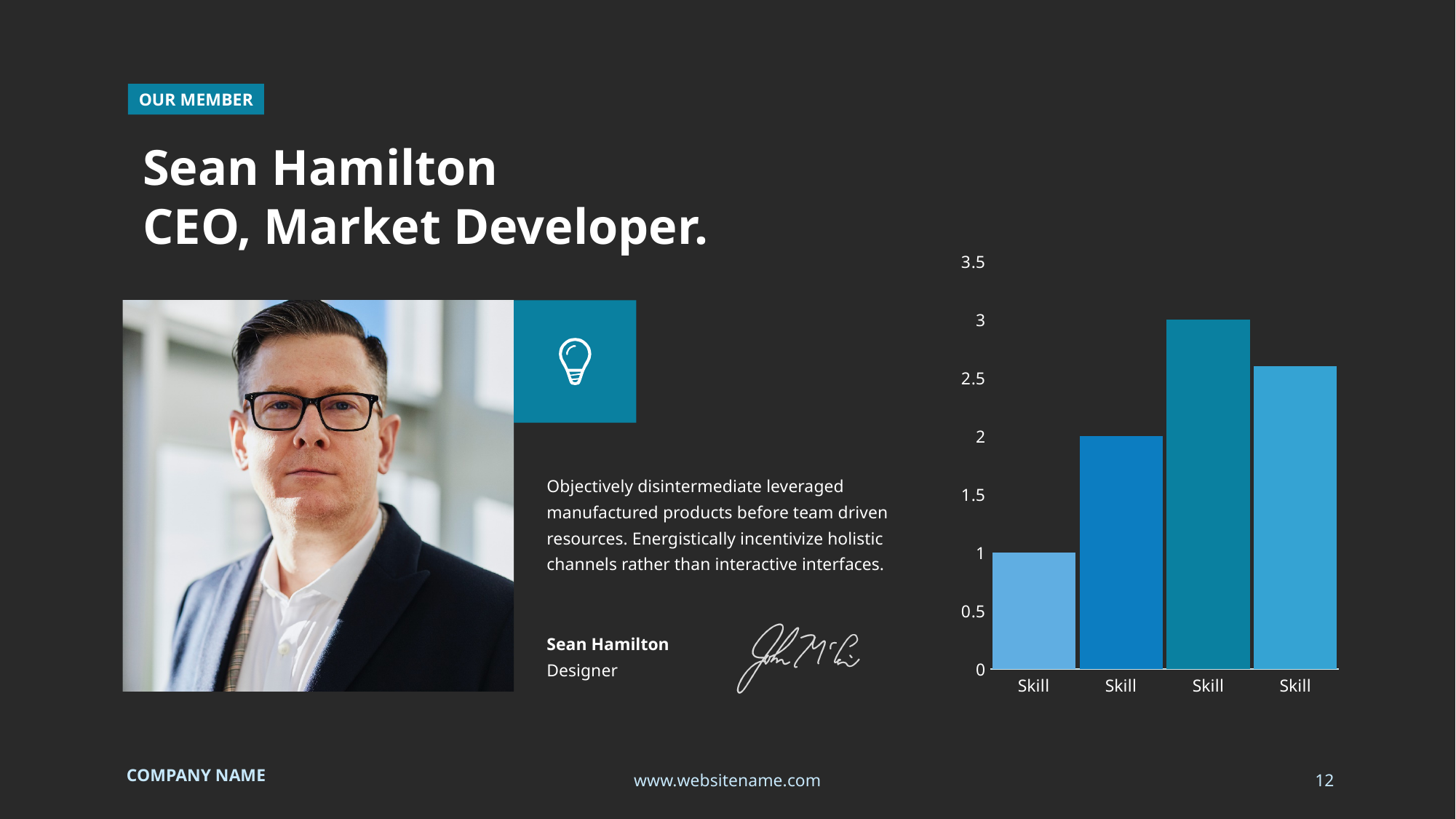
What kind of chart is shown on the slide? bar chart Is the value of the fourth bar from the left greater or less than 2.5? greater What is the difference between the third bar and the first bar from the left? 2 How many bars does the chart show? 4 Which bar is the shortest? the first bar from the left What is the value of the third bar from the left? 3 Which is larger, the second bar from the left or the fourth bar from the left? the fourth bar from the left Is the value of the fourth bar from the left greater or less than 3? less What is the value of the second bar from the left? 2 What label appears under each bar on the x axis? Skill Which bar is the tallest? the third bar from the left What is the value of the first bar from the left? 1